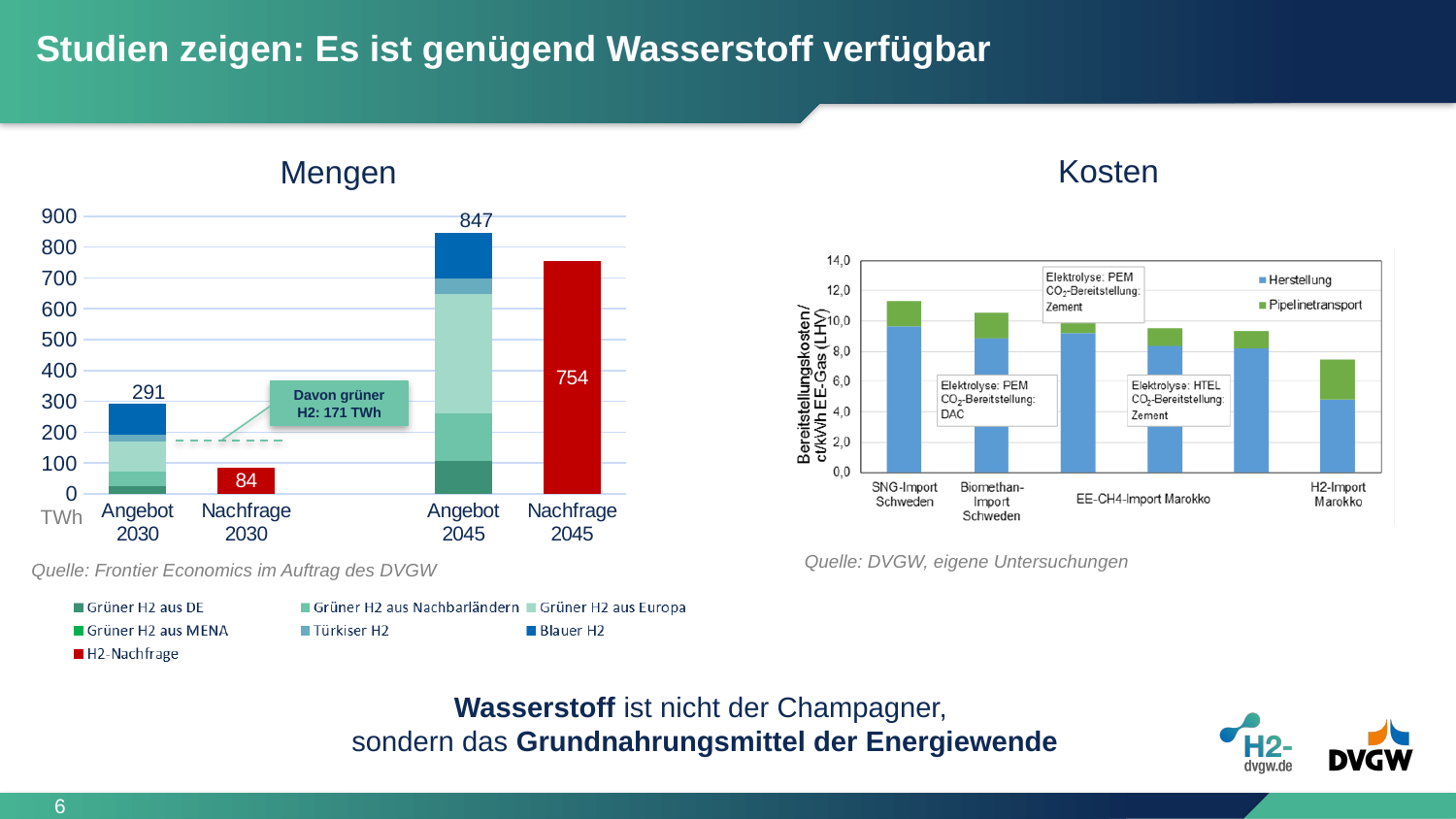
In the Mengen chart, what is the difference between Angebot 2030 (291) and Nachfrage 2030 (84)? 207 In the Mengen chart, what is the total value shown for Angebot 2030? 291 In the Kosten chart, is the total value for SNG-Import Schweden greater or less than 10,0? greater In the Mengen chart, which bar has the lowest value? Nachfrage 2030 In the Mengen chart, what is the total value shown for Angebot 2045? 847 In the Mengen chart, what is the difference between Angebot 2045 (847) and Nachfrage 2045 (754)? 93 In the Mengen chart, what is the value shown for Nachfrage 2030? 84 In the Kosten chart, how many series does the legend list? 2 In the Mengen chart, how many series does the legend list? 7 In the Mengen chart, which bar has the highest total value? Angebot 2045 What kind of chart is the Kosten chart? bar chart In the Mengen chart, how much of the Angebot 2030 is green hydrogen according to the annotation? 171 TWh